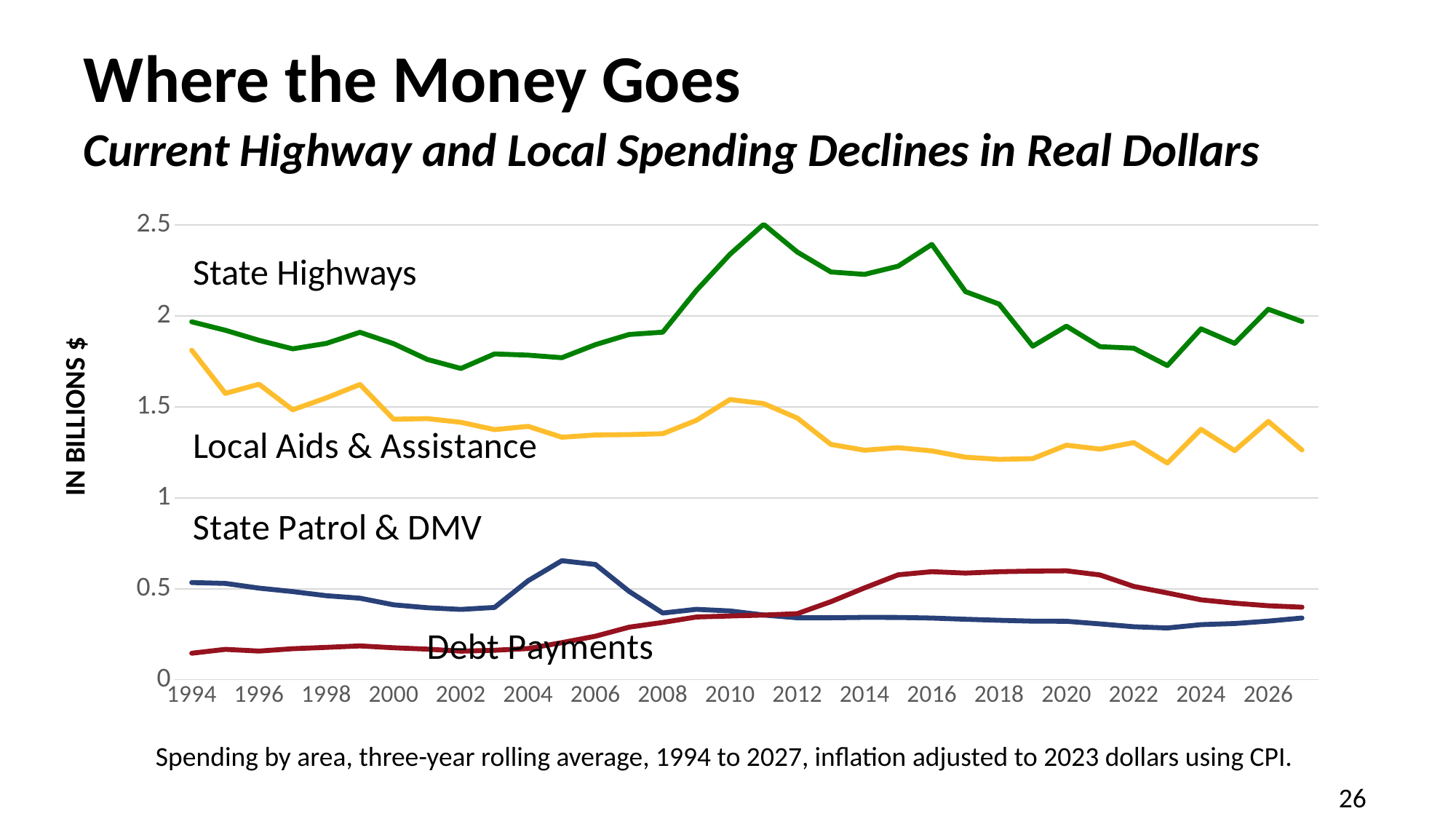
Does Local Aids & Assistance spending rise or fall overall from 1994 to 2027? Fall In 2016, which is larger: Debt Payments or State Patrol & DMV? Debt Payments Is the value for State Highways in 2011 greater or less than 2? greater Is the value for Debt Payments in 1994 greater or less than 0.5? less Is the value for State Highways in 2002 greater or less than 2? less What kind of chart is shown on the slide? Line chart Which series has the highest values across the whole chart? State Highways What is the label on the vertical axis? IN BILLIONS $ Which series has the lowest value in 1994? Debt Payments How many spending series are plotted on the chart? 4